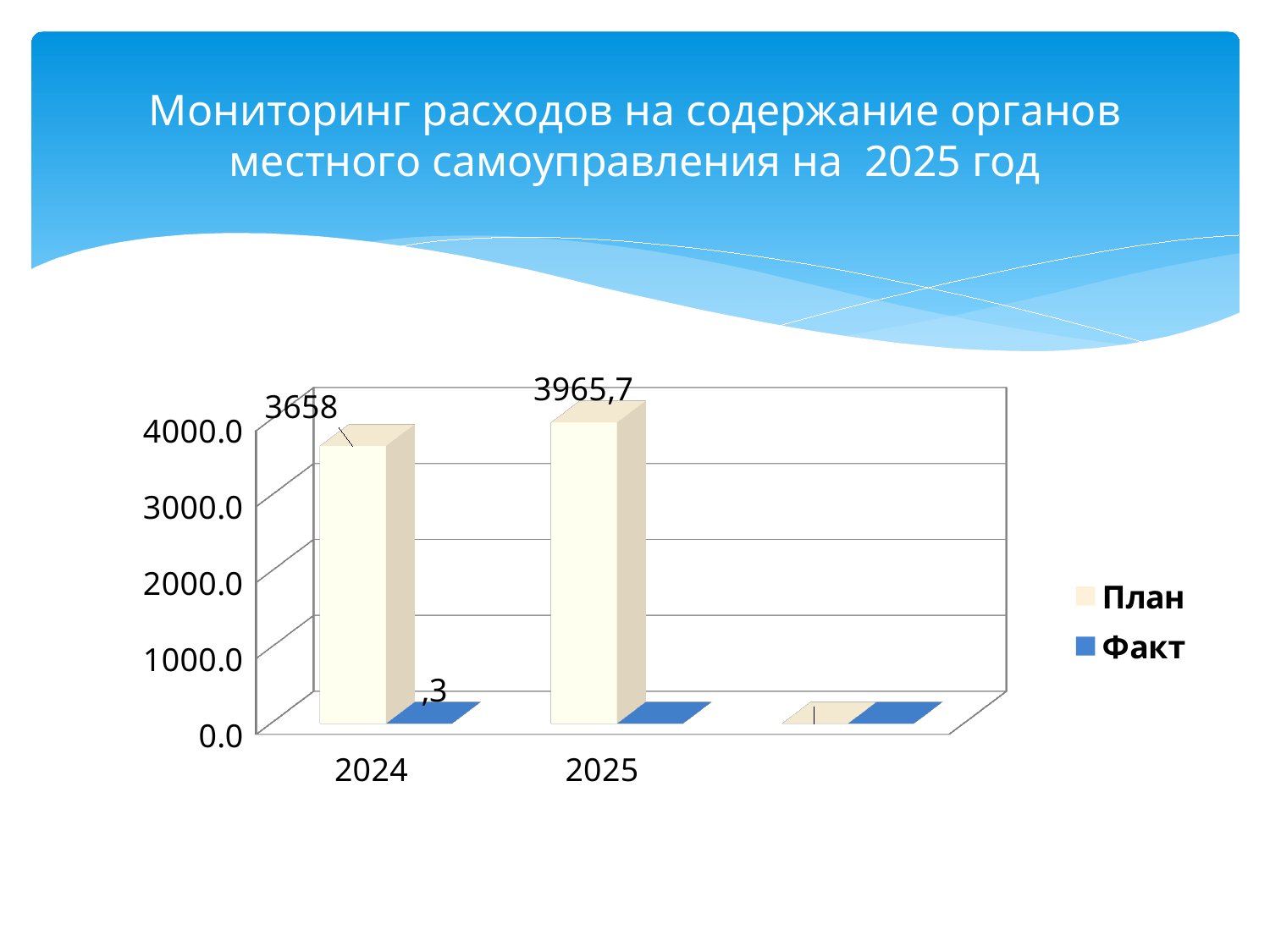
What are the two series named in the legend? План and Факт Is the Факт value for 2024 greater or less than 1000? less Which year has the lowest План value? 2024 What is the difference between the План values for 2025 and 2024? 307,7 How many series does the legend list? 2 Which year has the higher План value, 2024 or 2025? 2025 Which year has the highest План value? 2025 What is the План value for 2024? 3658 What is the План value for 2025? 3965,7 Does the План value rise or fall from 2024 to 2025? Rise Is the План value for 2024 greater or less than 3000? greater What kind of chart is shown on the slide? Bar chart